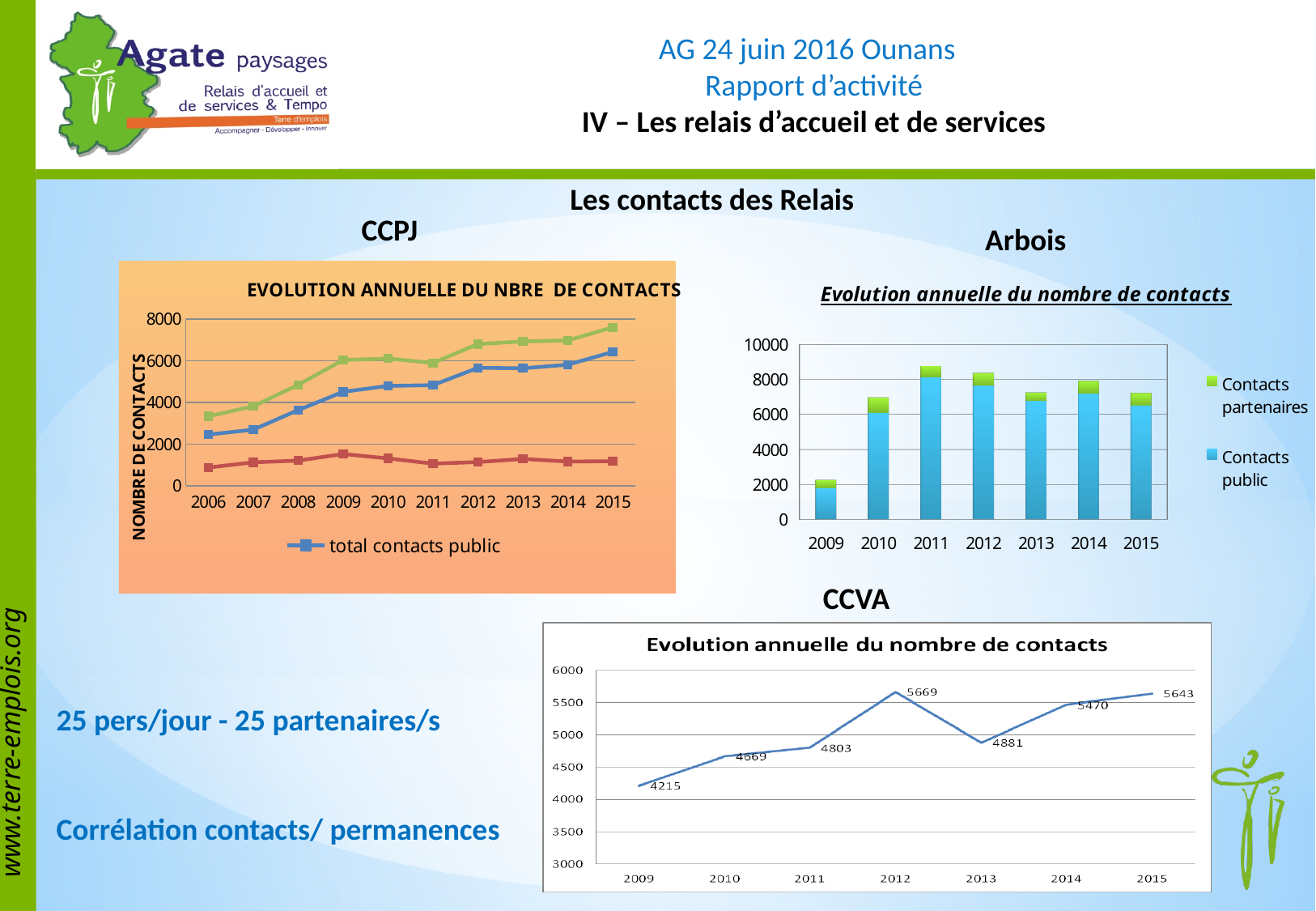
On the CCPJ chart, does the 'total contacts public' series rise or fall from 2006 to 2015? Rises On the Arbois chart, which year has the tallest bar? 2011 What kind of chart is the Arbois chart? Bar chart On the CCVA chart, what is the difference between the 2015 value and the 2014 value? 173 On the CCVA chart, what is the value for 2009? 4215 On the CCVA chart, which year has the lowest number of contacts? 2009 On the CCVA chart, how many years are plotted? 7 On the CCVA chart, what is the value for 2012? 5669 On the CCVA chart, which year has the highest number of contacts? 2012 On the Arbois chart, how many series does the legend list? 2 On the Arbois chart, is the total for 2009 greater or less than 4000? less On the CCVA chart, which is larger, the value for 2013 or the value for 2011? 2013